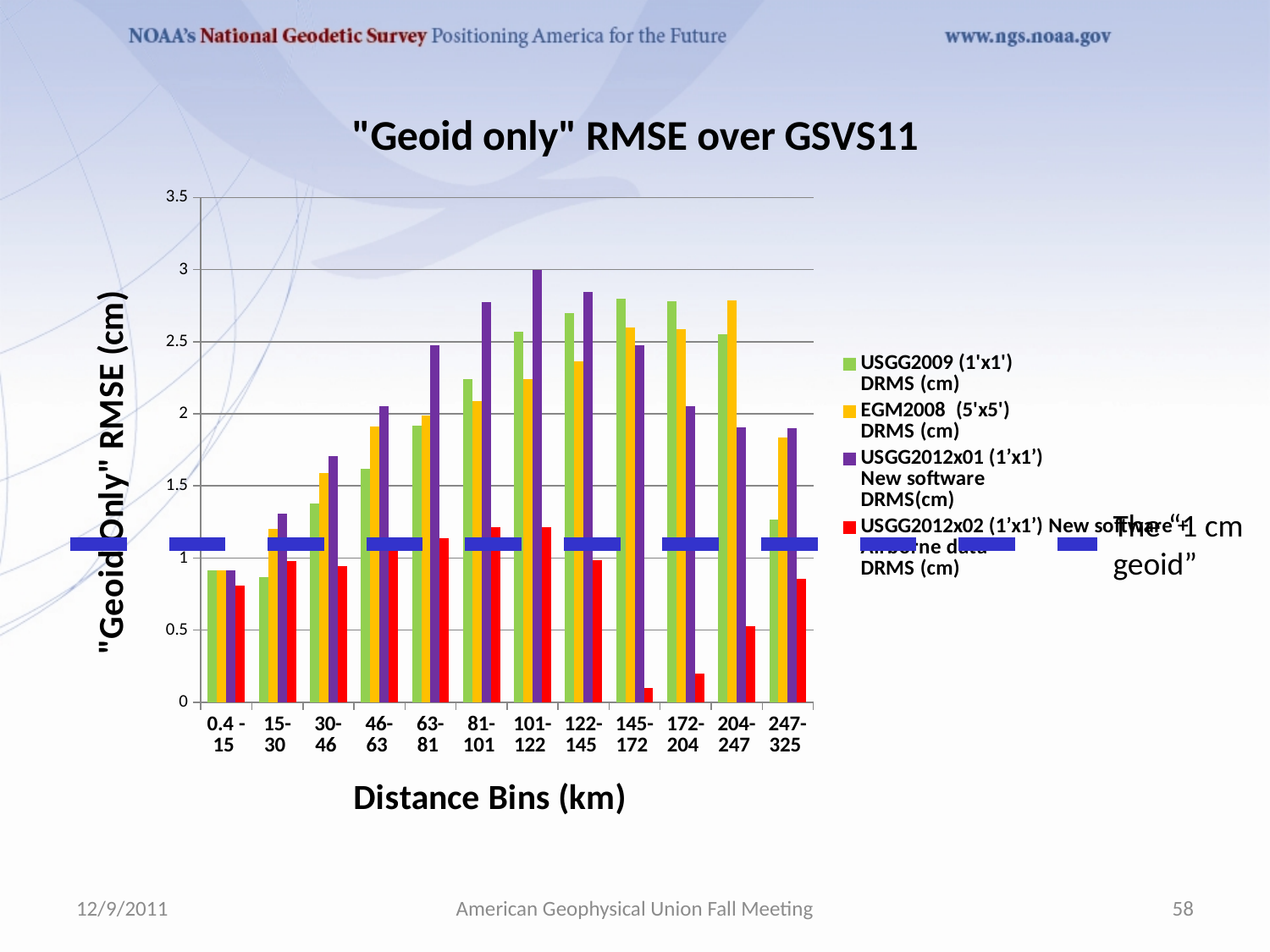
In which distance bin is the USGG2012x01 (1'x1') New software DRMS value highest? 101-122 Is the EGM2008 (5'x5') DRMS value for the 204-247 km bin greater or less than 2.5? greater How many distance bins are shown on the x axis? 12 In the 63-81 km bin, which is larger: the USGG2009 (1'x1') DRMS value or the USGG2012x01 (1'x1') New software DRMS value? USGG2012x01 (1'x1') New software DRMS (cm) What is the label of the x axis? Distance Bins (km) How many series does the legend list? 4 Is the USGG2012x01 (1'x1') New software DRMS value for the 101-122 km bin greater or less than 2.5? greater Is the USGG2012x02 (1'x1') New software + Airborne data DRMS value for the 145-172 km bin greater or less than 0.5? less What kind of chart is shown on the slide? Bar chart What is the title of the chart? "Geoid only" RMSE over GSVS11 Which series has the lowest value in the 145-172 km bin? USGG2012x02 (1'x1') New software + Airborne data DRMS (cm)